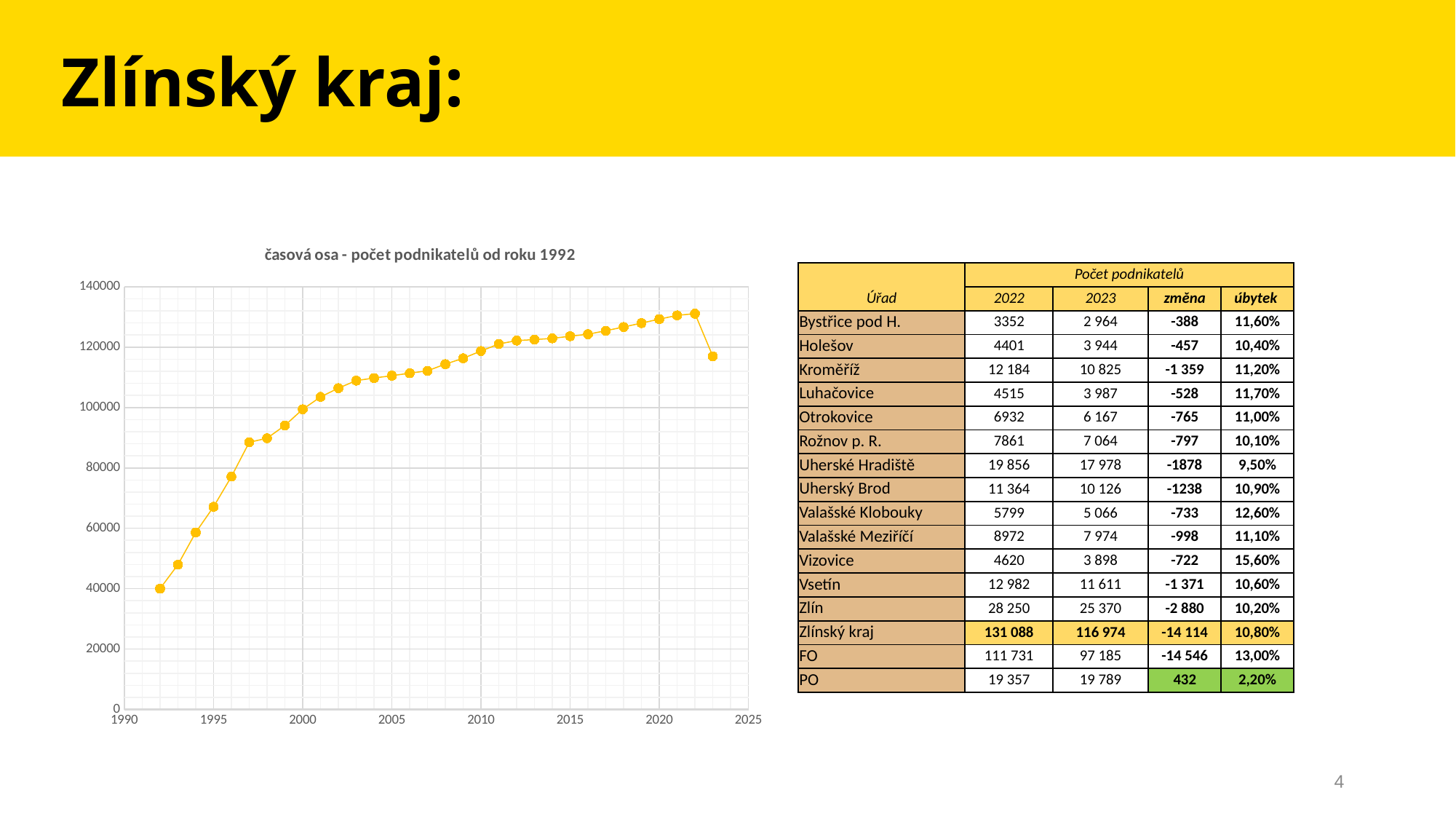
Which year has the larger value, 2022 or 2023? 2022 What is the highest value shown on the chart's vertical axis? 140000 Is the value for 1995 greater or less than 60000? greater Is the value for 2022 greater or less than 120000? greater Is the value for 2023 greater or less than 120000? less What kind of chart is shown on the slide? line chart What is the title of the chart on the slide? časová osa - počet podnikatelů od roku 1992 How do the values change from 1992 to 2022 along the x axis? they rise In which year does the chart reach its highest value? 2022 In which year does the chart show its lowest value? 1992